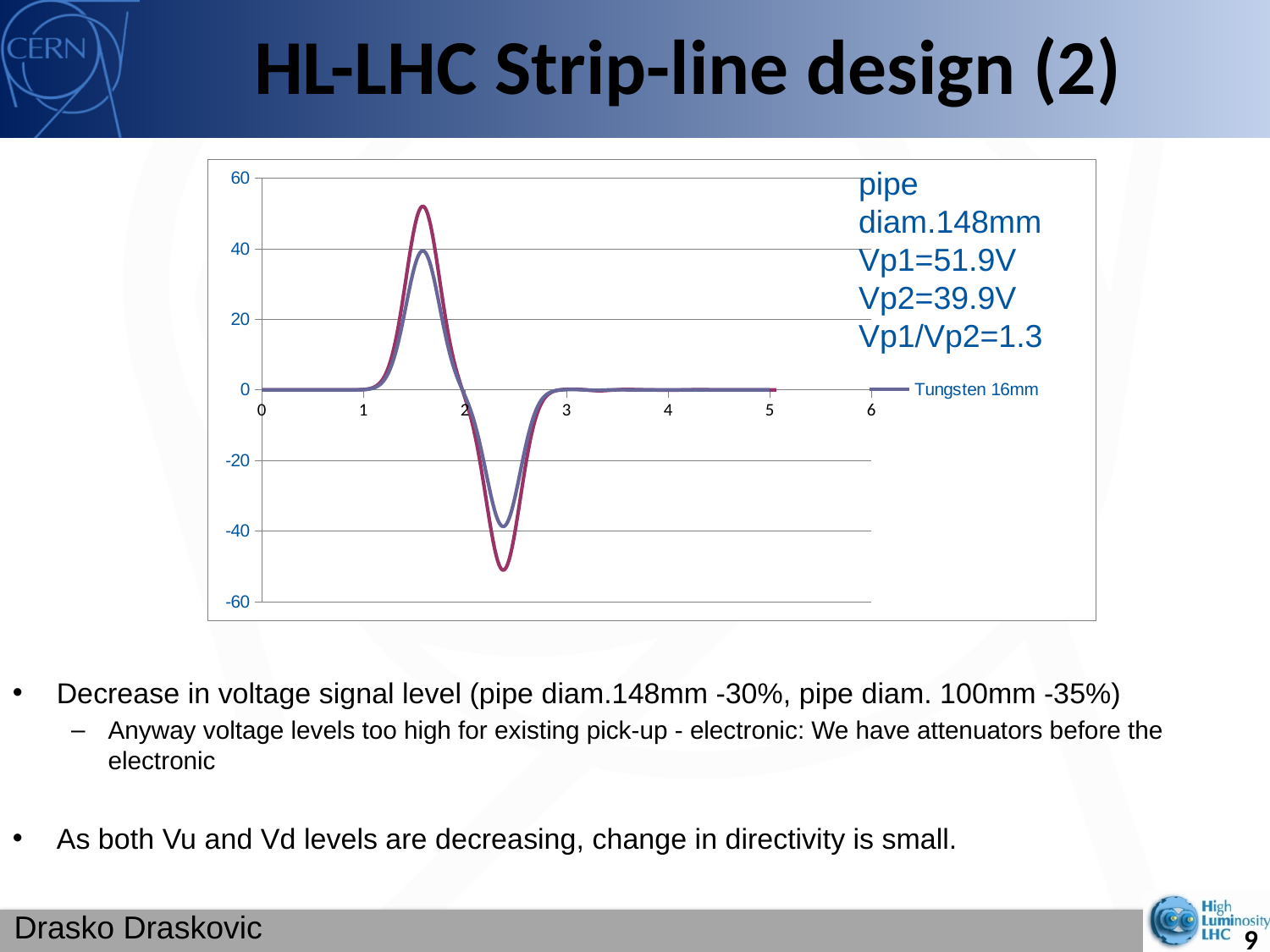
What kind of chart is shown on the slide? line chart Is the peak value of the red curve greater or less than 40? greater What is the highest value shown on the vertical axis of the chart? 60 What is the lowest value shown on the vertical axis of the chart? -60 According to the annotation on the chart, what is the ratio Vp1/Vp2? 1.3 What series name is shown in the chart legend? Tungsten 16mm What is the difference between Vp1 and Vp2 as given in the chart annotation? 12V According to the annotation on the chart, what is Vp1? 51.9V How many curves are plotted on the chart? 2 According to the annotation on the chart, what is Vp2? 39.9V Is the minimum value of the red curve greater or less than -40? less